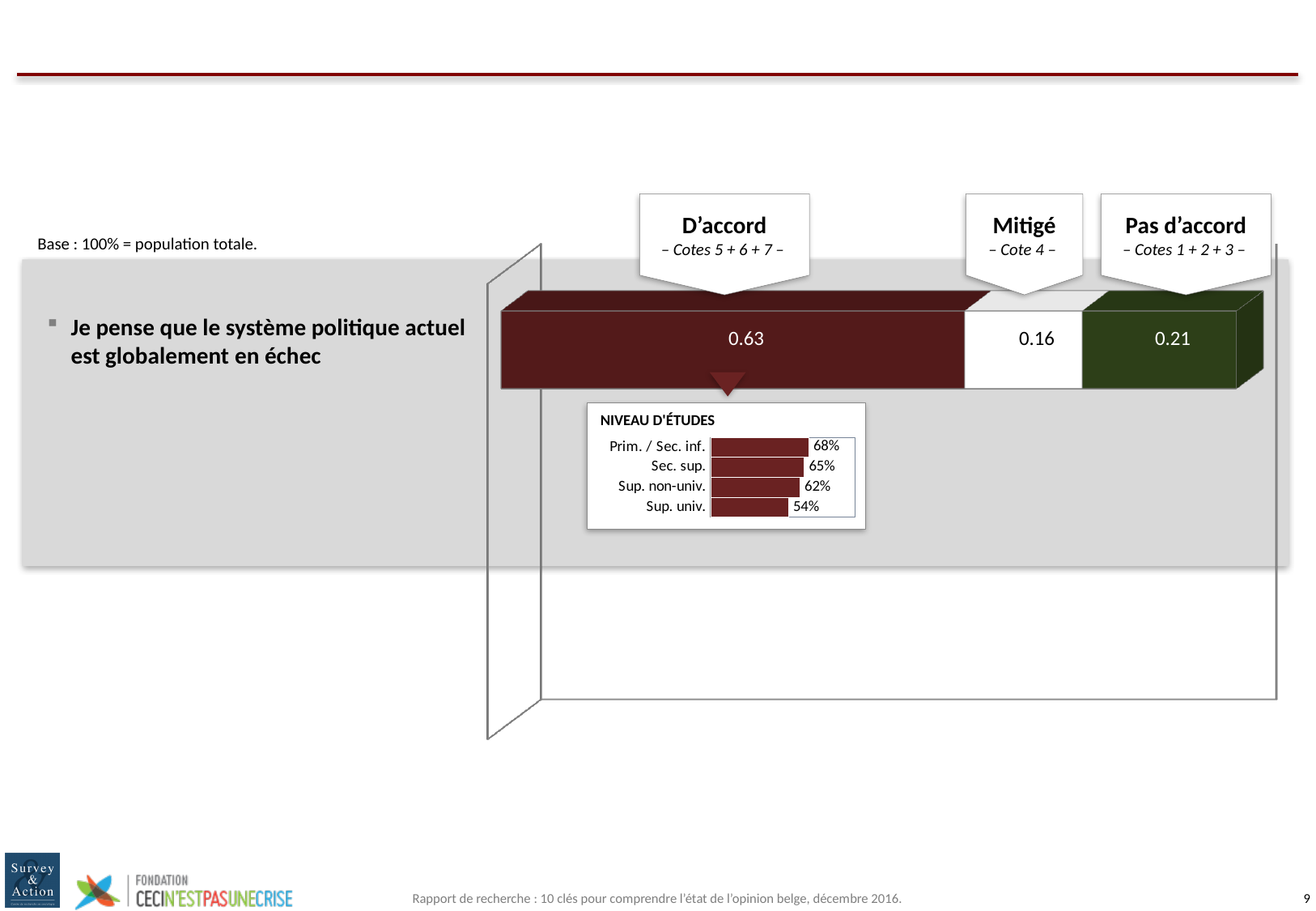
In the stacked bar for 'Je pense que le système politique actuel est globalement en échec', what is the value for 'D'accord'? 0.63 In the stacked bar for 'Je pense que le système politique actuel est globalement en échec', what is the difference between 'D'accord' and 'Pas d'accord'? 0.42 In the stacked bar for 'Je pense que le système politique actuel est globalement en échec', which segment is the smallest? Mitigé In the 'NIVEAU D'ÉTUDES' chart, how many categories are shown? 4 In the 'NIVEAU D'ÉTUDES' chart, what is the difference between 'Prim. / Sec. inf.' and 'Sup. univ.'? 14% In the stacked bar for 'Je pense que le système politique actuel est globalement en échec', which is larger: 'Mitigé' or 'Pas d'accord'? Pas d'accord In the stacked bar for 'Je pense que le système politique actuel est globalement en échec', which segment is the largest? D'accord In the stacked bar for 'Je pense que le système politique actuel est globalement en échec', what is the value for 'Mitigé'? 0.16 In the 'NIVEAU D'ÉTUDES' chart, which category has the highest value? Prim. / Sec. inf. In the 'NIVEAU D'ÉTUDES' chart, what is the value for 'Sup. univ.'? 54% In the stacked bar for 'Je pense que le système politique actuel est globalement en échec', what is the value for 'Pas d'accord'? 0.21 In the 'NIVEAU D'ÉTUDES' chart, what is the value for 'Sec. sup.'? 65%